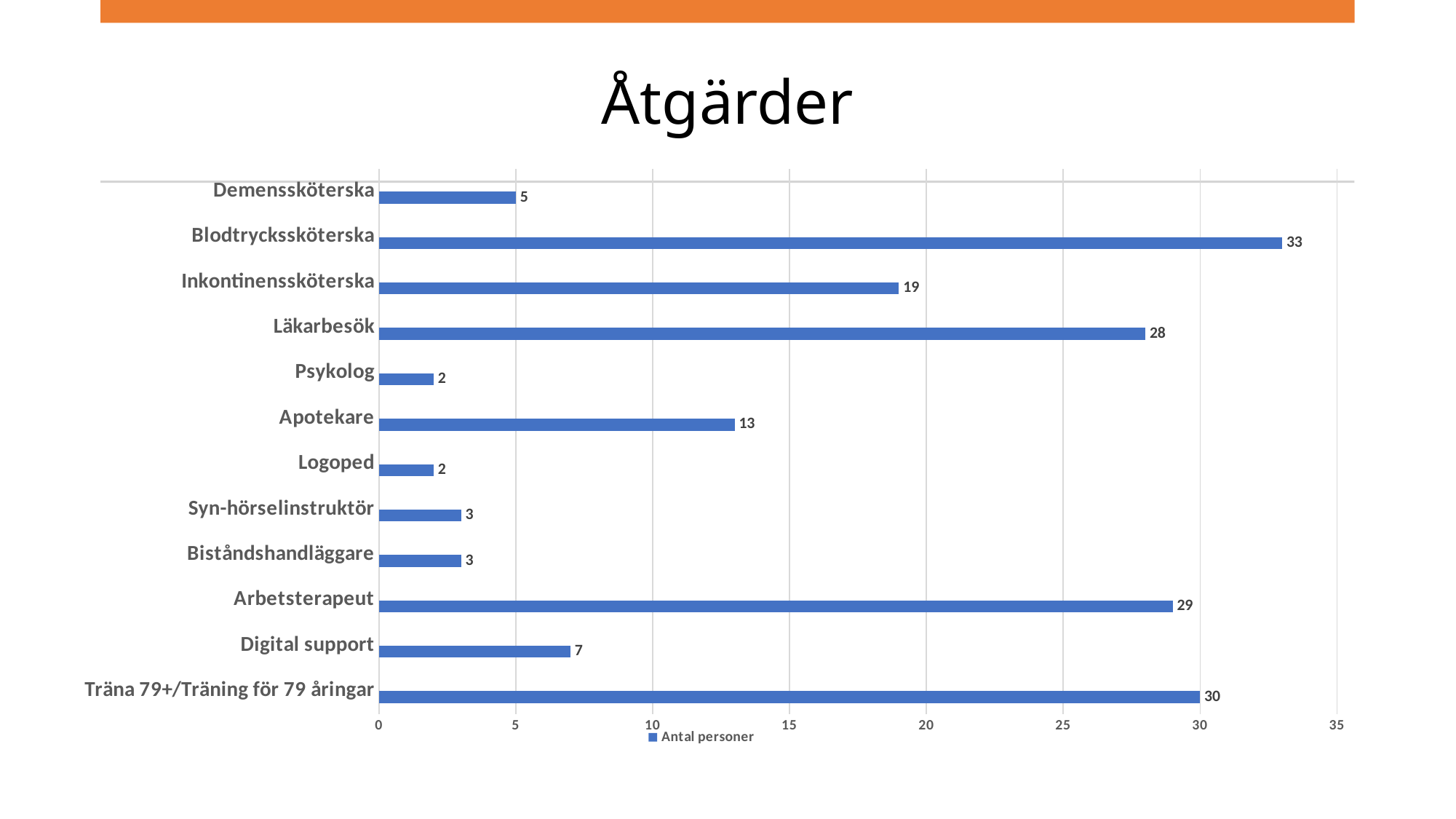
What is the difference between the values for Träna 79+/Träning för 79 åringar and Arbetsterapeut? 1 How many categories are shown in the chart? 12 What is the name of the series shown in the legend? Antal personer What is the difference between the values for Läkarbesök and Inkontinenssköterska? 9 Which is larger, the value for Inkontinenssköterska or the value for Apotekare? Inkontinenssköterska What kind of chart is shown on the slide? Bar chart Which is larger, the value for Demenssköterska or the value for Digital support? Digital support Which category has the highest value? Blodtryckssköterska What is the value for Digital support? 7 Is the value for Läkarbesök greater or less than 25? greater What is the value for Blodtryckssköterska? 33 What is the value for Apotekare? 13